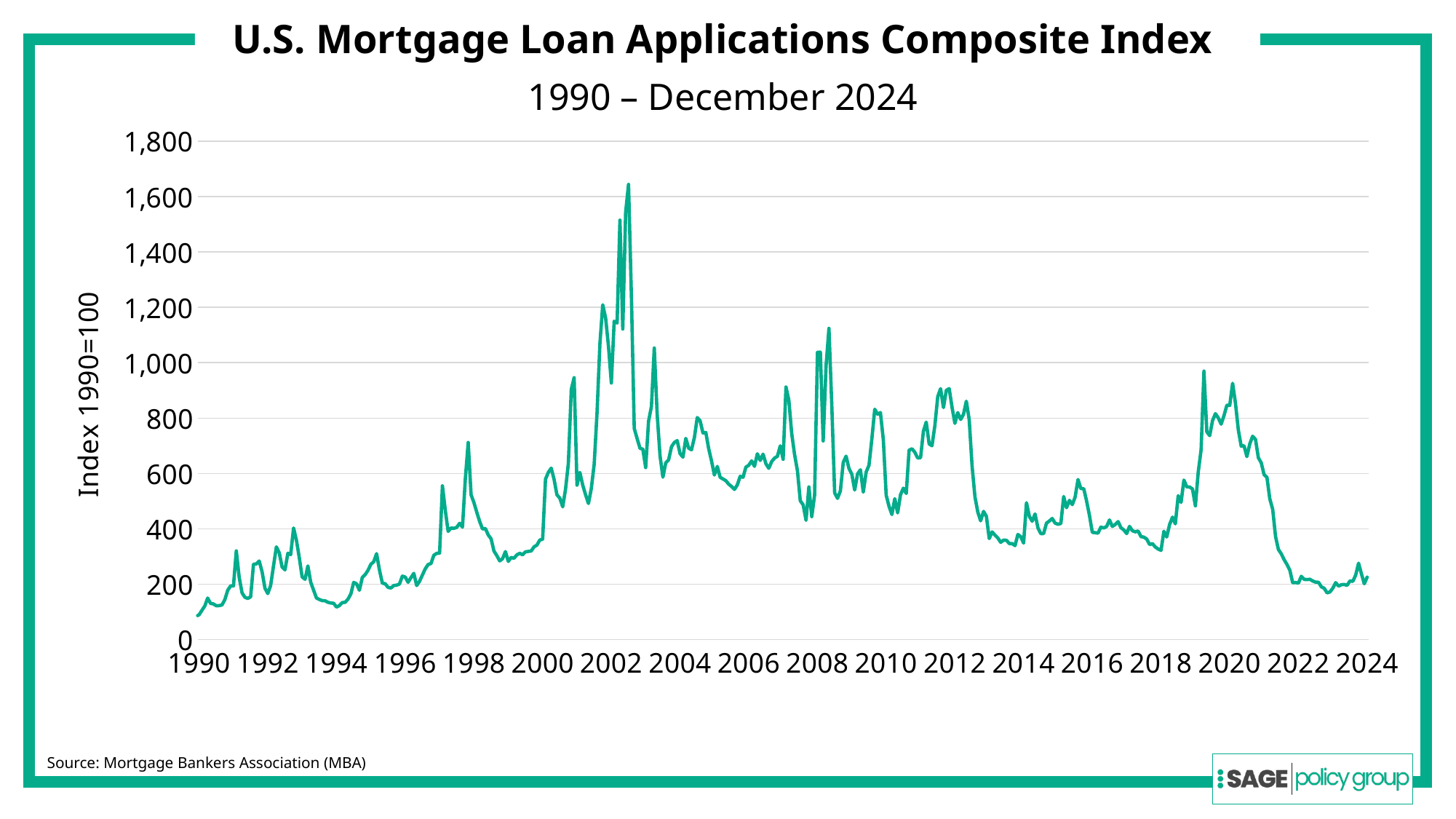
Which is higher: the peak of the index around 2003 or the peak around 2020? the peak around 2003 In which year does the index reach its highest peak? 2003 What kind of chart is shown on the slide? line chart How many lines are plotted on the chart? 1 Does the index generally rise or fall between 1990 and 2003? rise Is the peak of the index in 2020 greater or less than 800? greater Is the highest peak of the index, around 2003, greater or less than 1,400? greater Is the value of the index at the end of 2024 greater or less than 400? less What is the title of the chart? U.S. Mortgage Loan Applications Composite Index Does the index rise or fall between 2021 and 2023? fall What is the label on the vertical axis? Index 1990=100